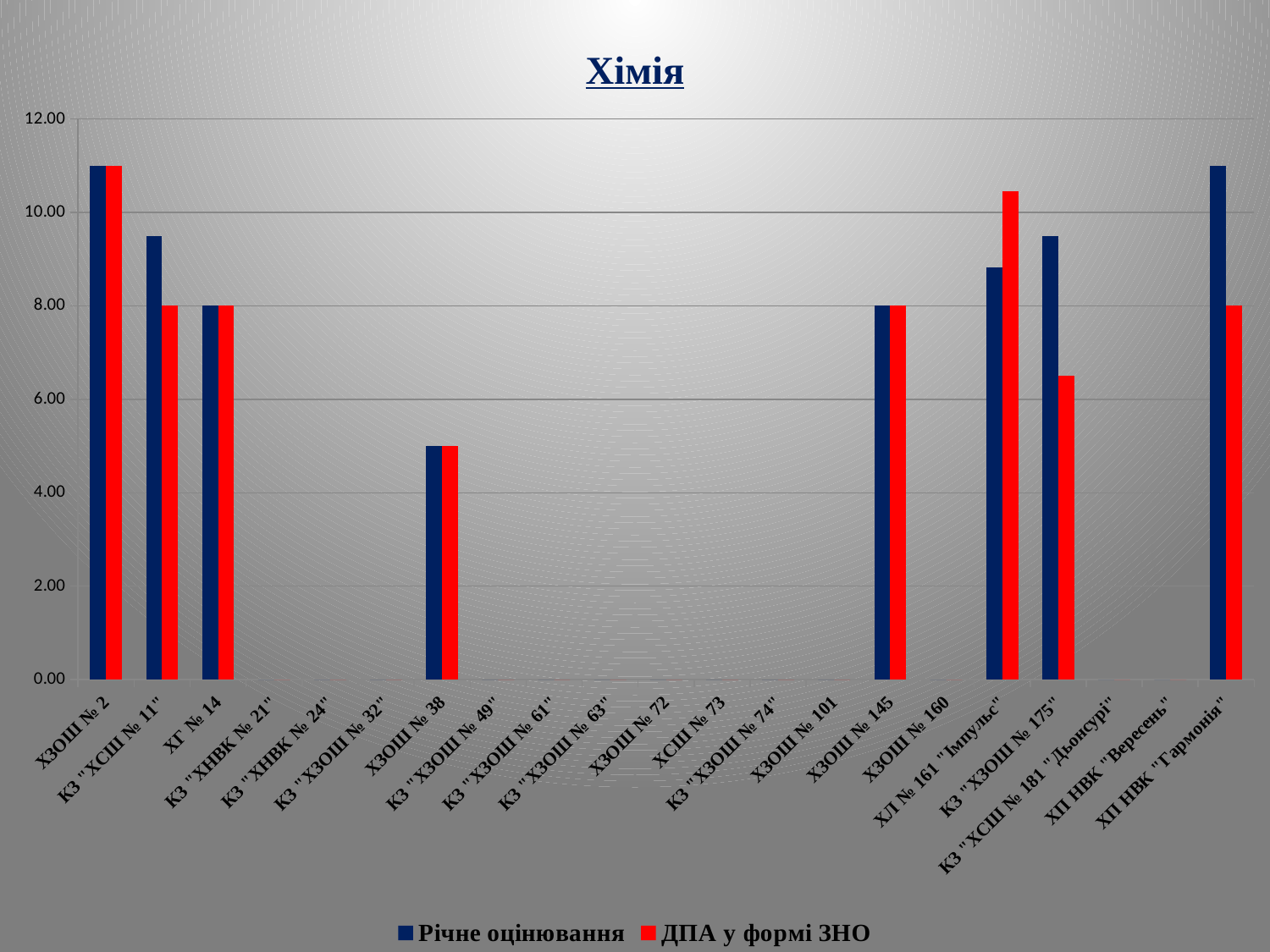
What is the ДПА у формі ЗНО value for ХГ № 14? 8.00 What is the Річне оцінювання value for ХЗОШ № 145? 8.00 What kind of chart is shown on the slide? bar chart How many categories on the x axis have bars plotted? 8 Is the ДПА у формі ЗНО value for ХЗОШ № 38 greater or less than 6? less For КЗ "ХЗОШ № 175", which is larger: Річне оцінювання or ДПА у формі ЗНО? Річне оцінювання Among the categories with bars, which has the lowest Річне оцінювання value? ХЗОШ № 38 Is the ДПА у формі ЗНО value for ХЛ № 161 "Імпульс" greater or less than 10? greater Which series is shown in red in the legend? ДПА у формі ЗНО What is the title of the chart? Хімія Is the Річне оцінювання value for ХЗОШ № 2 greater or less than 10? greater How many series does the legend list? 2